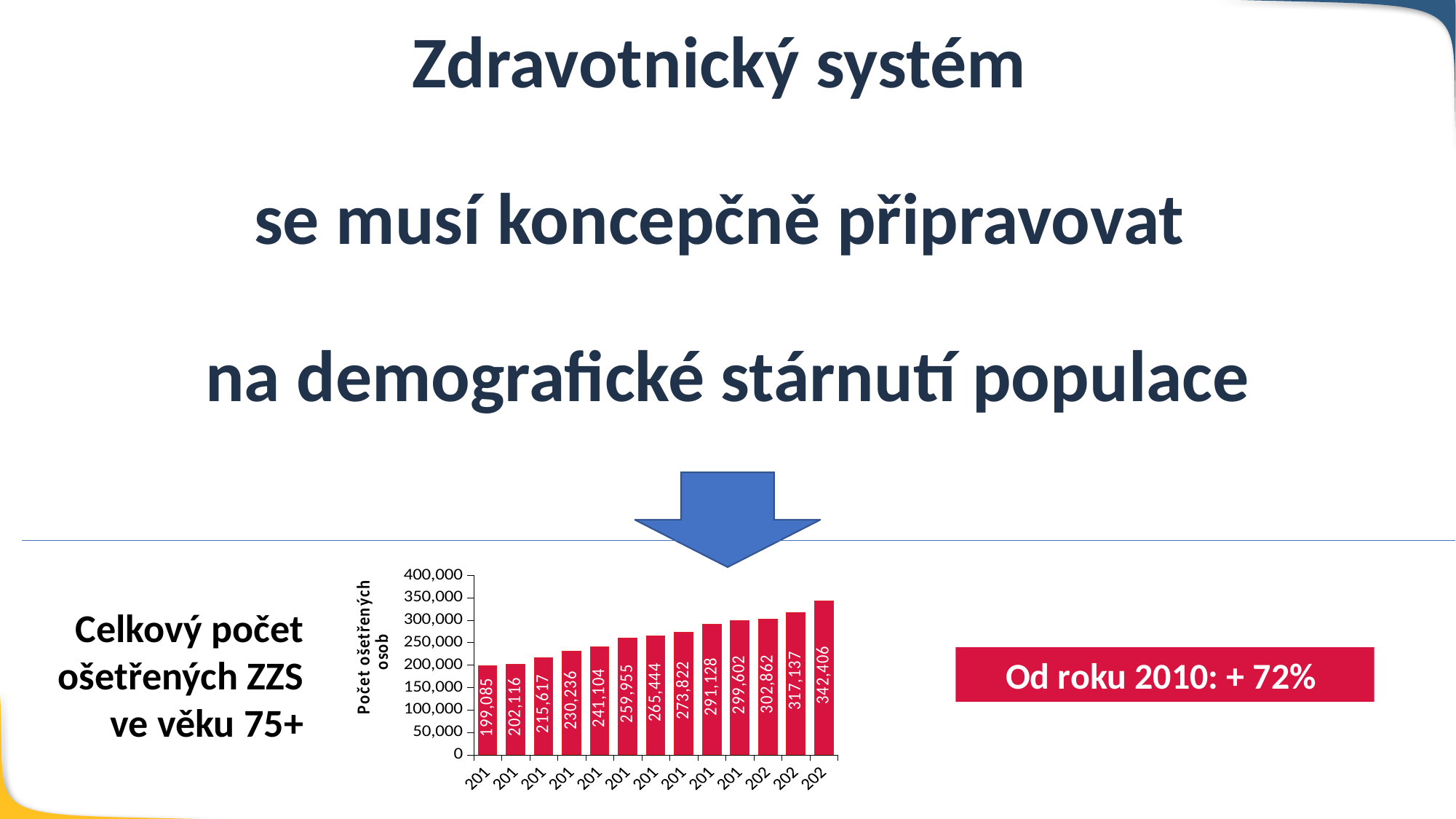
Is the value of the rightmost bar greater or less than 300,000? greater What kind of chart is shown at the bottom of the slide? bar chart What is the difference between the last bar (342,406) and the first bar (199,085)? 143,321 How many bars does the chart contain? 13 What is the value shown on the first (leftmost) bar of the chart? 199,085 Which is larger, the value of the first bar or the value of the last bar? the last bar What is the title of the vertical axis of the chart? Počet ošetřených osob Do the values in the chart rise or fall from left to right? rise What is the value shown on the fifth bar from the left? 241,104 What is the value shown on the last (rightmost) bar of the chart? 342,406 What is the value of the shortest bar in the chart? 199,085 What is the value of the tallest bar in the chart? 342,406